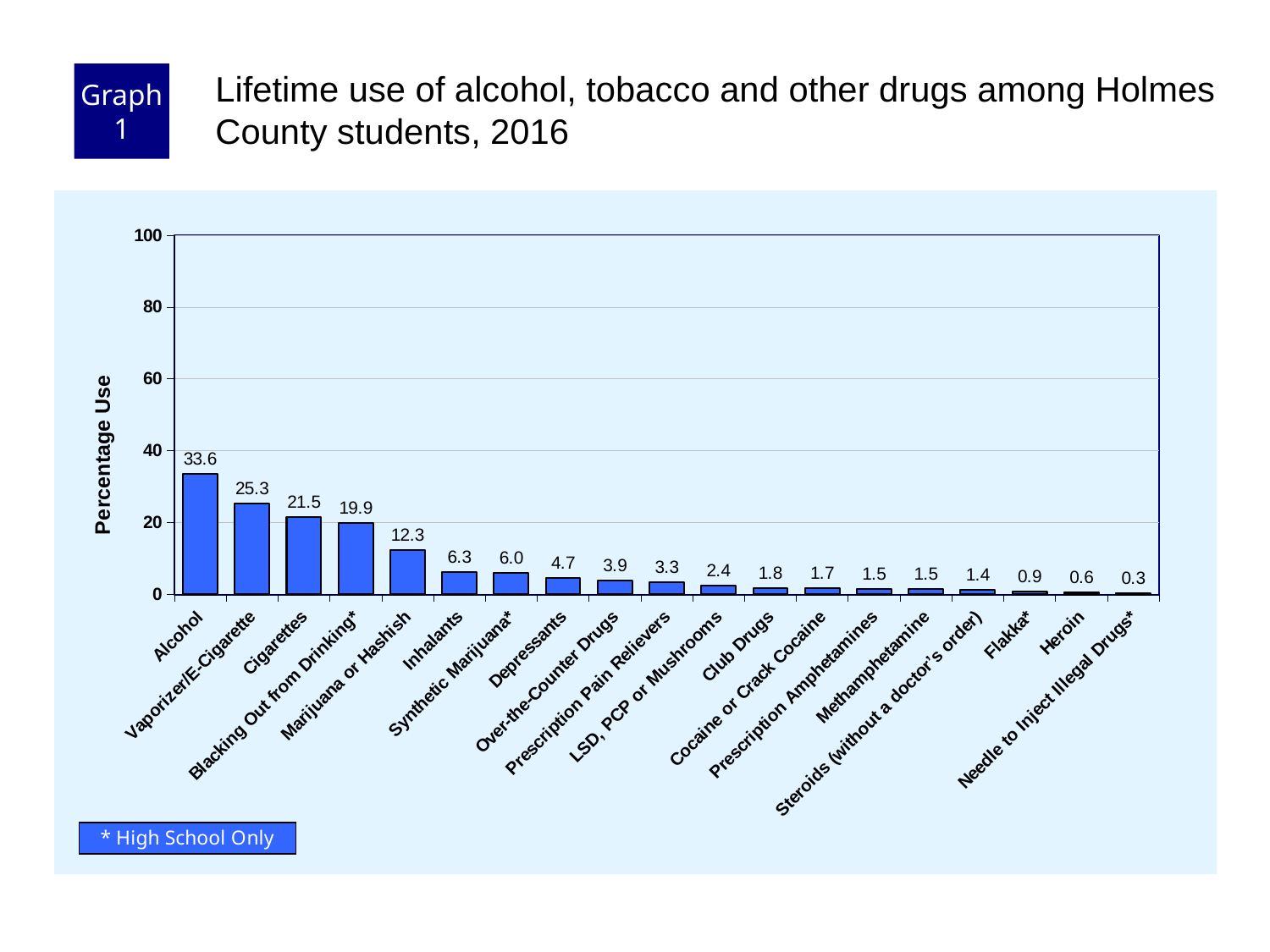
Is the value for Vaporizer/E-Cigarette greater or less than 20? greater Which is larger, the value for Inhalants or the value for Depressants? Inhalants What is the difference between the values for Vaporizer/E-Cigarette and Blacking Out from Drinking*? 5.4 How many categories are shown on the x axis? 19 What is the value shown for Heroin? 0.6 What is the label of the y axis? Percentage Use What kind of chart is this? bar chart What is the difference between the values for Alcohol and Cigarettes? 12.1 What is the value shown for Marijuana or Hashish? 12.3 Which category has the highest value? Alcohol Which category has the lowest value? Needle to Inject Illegal Drugs* What is the lifetime use percentage for Alcohol? 33.6